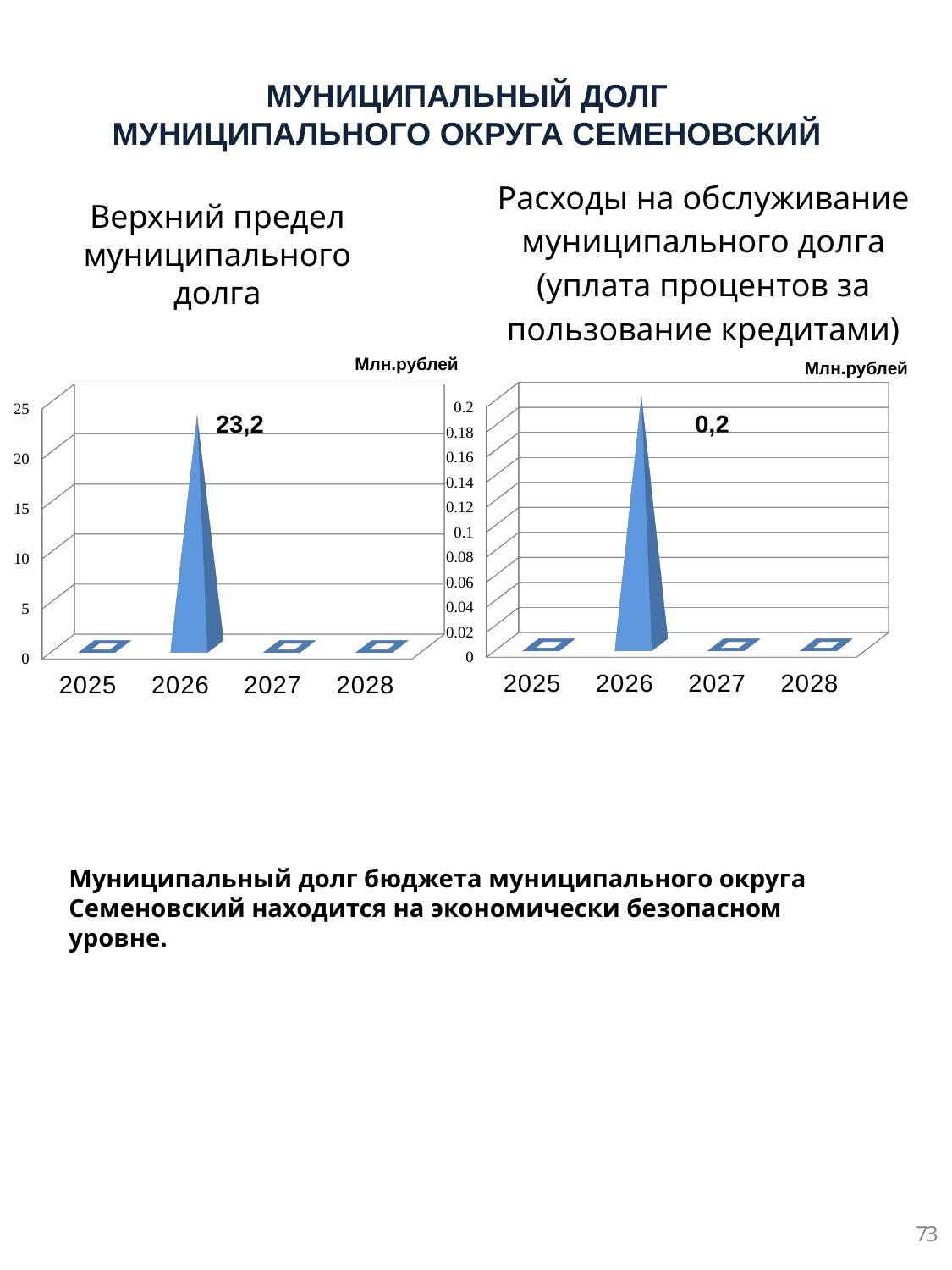
In the right chart ("Расходы на обслуживание муниципального долга"), is the value for 2025 greater or less than 0.1? less In the chart titled "Расходы на обслуживание муниципального долга (уплата процентов за пользование кредитами)", what is the value for 2026? 0,2 In the right chart ("Расходы на обслуживание муниципального долга"), which year has the highest value? 2026 What kind of chart is the right chart ("Расходы на обслуживание муниципального долга")? bar chart In the chart titled "Верхний предел муниципального долга", what is the value for 2026? 23,2 In the left chart ("Верхний предел муниципального долга"), is the value for 2027 greater or less than 5? less In the left chart ("Верхний предел муниципального долга"), is the value for 2026 greater or less than 20? greater In the left chart ("Верхний предел муниципального долга"), which is larger, the value for 2026 or the value for 2028? 2026 In the left chart ("Верхний предел муниципального долга"), which year has the highest value? 2026 What unit is indicated above the left chart ("Верхний предел муниципального долга")? Млн.рублей In the right chart ("Расходы на обслуживание муниципального долга"), which is larger, the value for 2025 or the value for 2026? 2026 How many years are shown on the x axis of the left chart ("Верхний предел муниципального долга")? 4